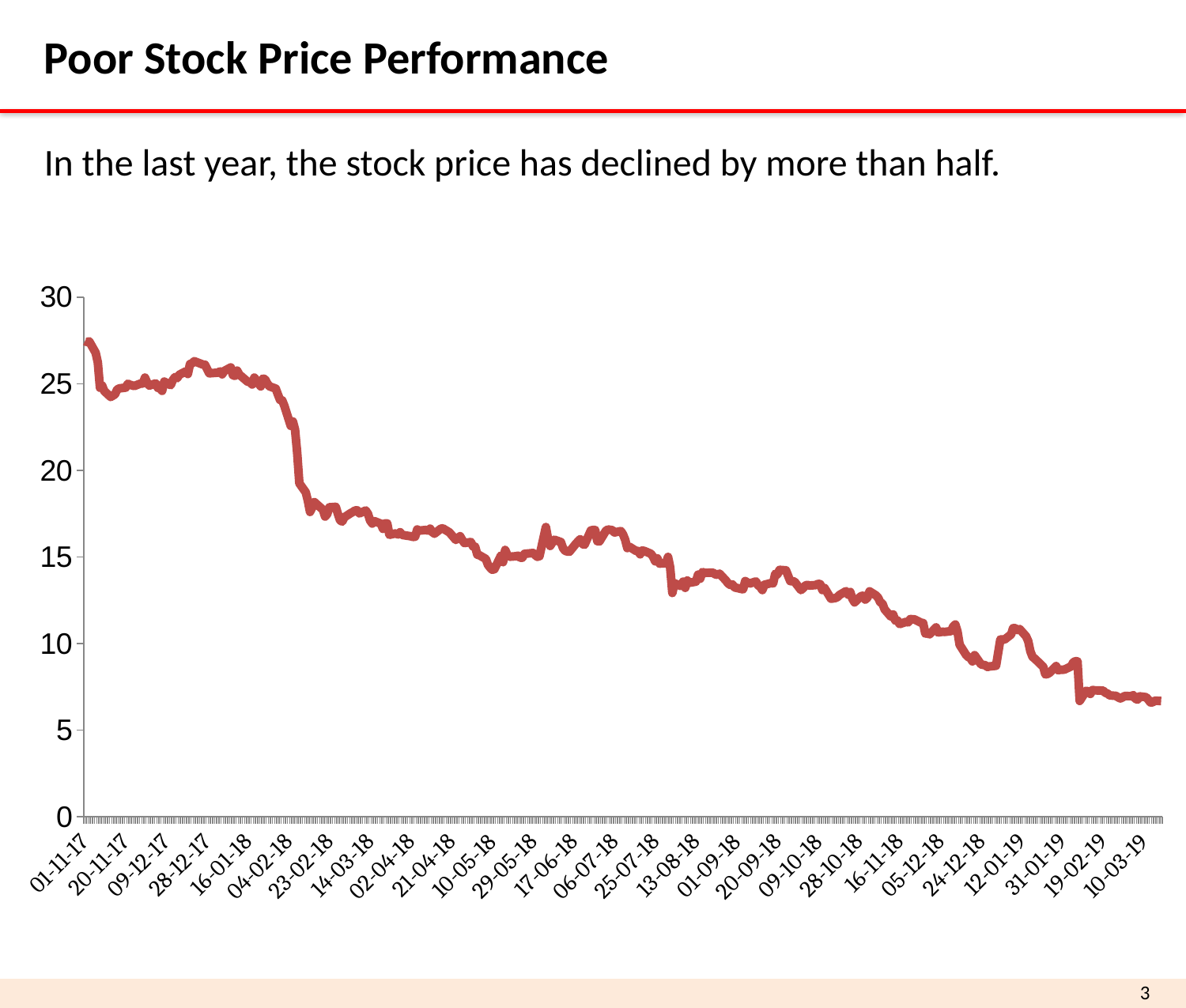
Is the value at 01-11-17 greater or less than 25? greater What is the title of the slide containing the chart? Poor Stock Price Performance Is the value at 10-03-19 greater or less than 10? less Which is larger, the value at 06-07-18 or the value at 05-12-18? 06-07-18 Is the value at 16-01-18 greater or less than 20? greater What is the highest value shown on the y axis of the chart? 30 What kind of chart is shown on the slide? line chart Do the values in the chart generally rise or fall from left to right along the x axis? fall Which is larger, the value at 01-11-17 or the value at 10-03-19? 01-11-17